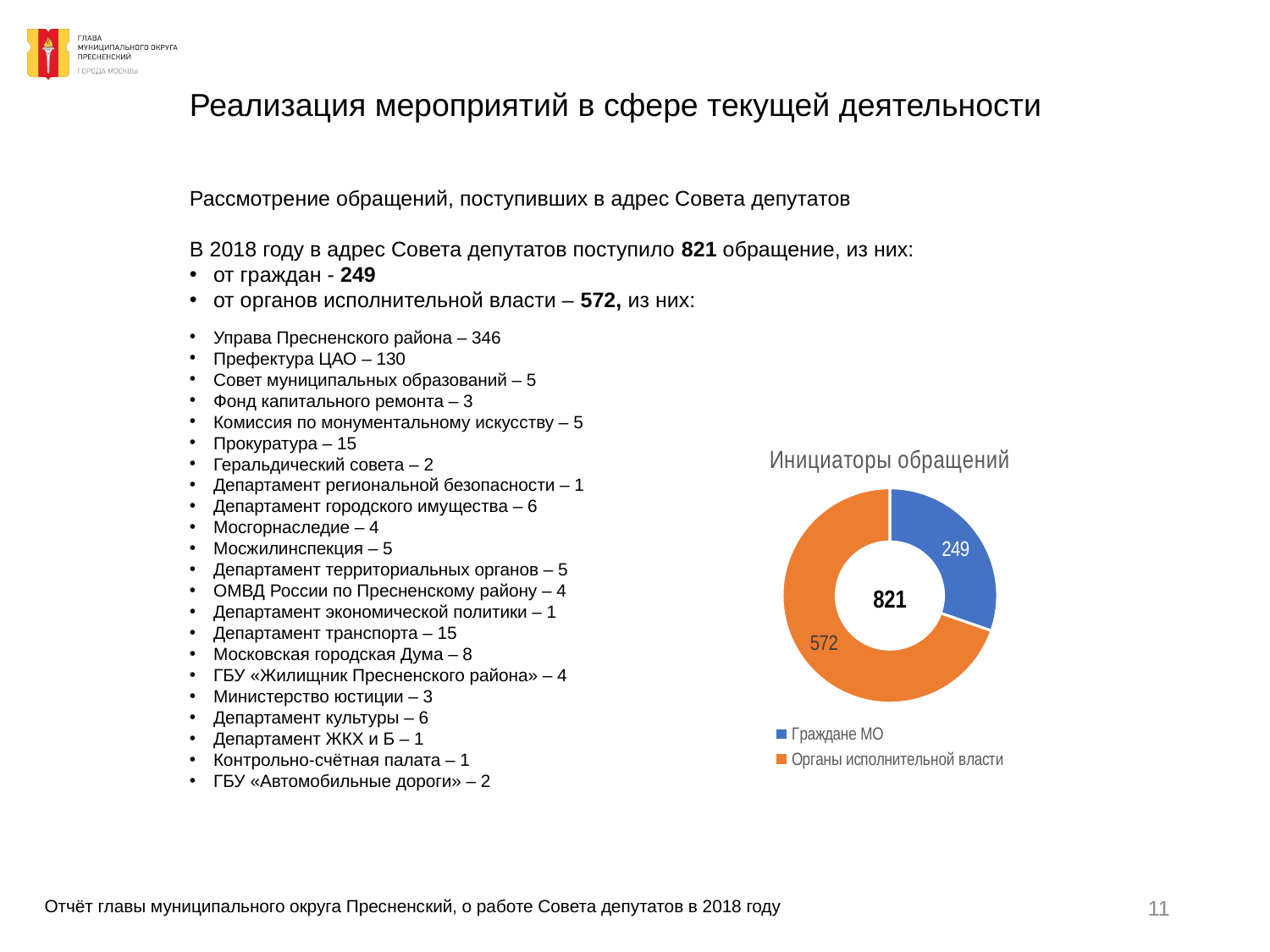
Which category has the smallest slice in the chart 'Инициаторы обращений'? Граждане МО How many entries does the legend of the chart 'Инициаторы обращений' list? 2 What colour is the slice for Граждане МО in the chart 'Инициаторы обращений'? blue What is the difference between the values for Органы исполнительной власти and Граждане МО in the chart 'Инициаторы обращений'? 323 What is the value for Граждане МО in the chart 'Инициаторы обращений'? 249 How many categories are shown in the chart 'Инициаторы обращений'? 2 What kind of chart is 'Инициаторы обращений'? doughnut chart In the chart 'Инициаторы обращений', which is larger: Граждане МО or Органы исполнительной власти? Органы исполнительной власти What number is printed in the centre of the chart 'Инициаторы обращений'? 821 What is the total of the two slices in the chart 'Инициаторы обращений'? 821 What is the value for Органы исполнительной власти in the chart 'Инициаторы обращений'? 572 Which category has the largest slice in the chart 'Инициаторы обращений'? Органы исполнительной власти